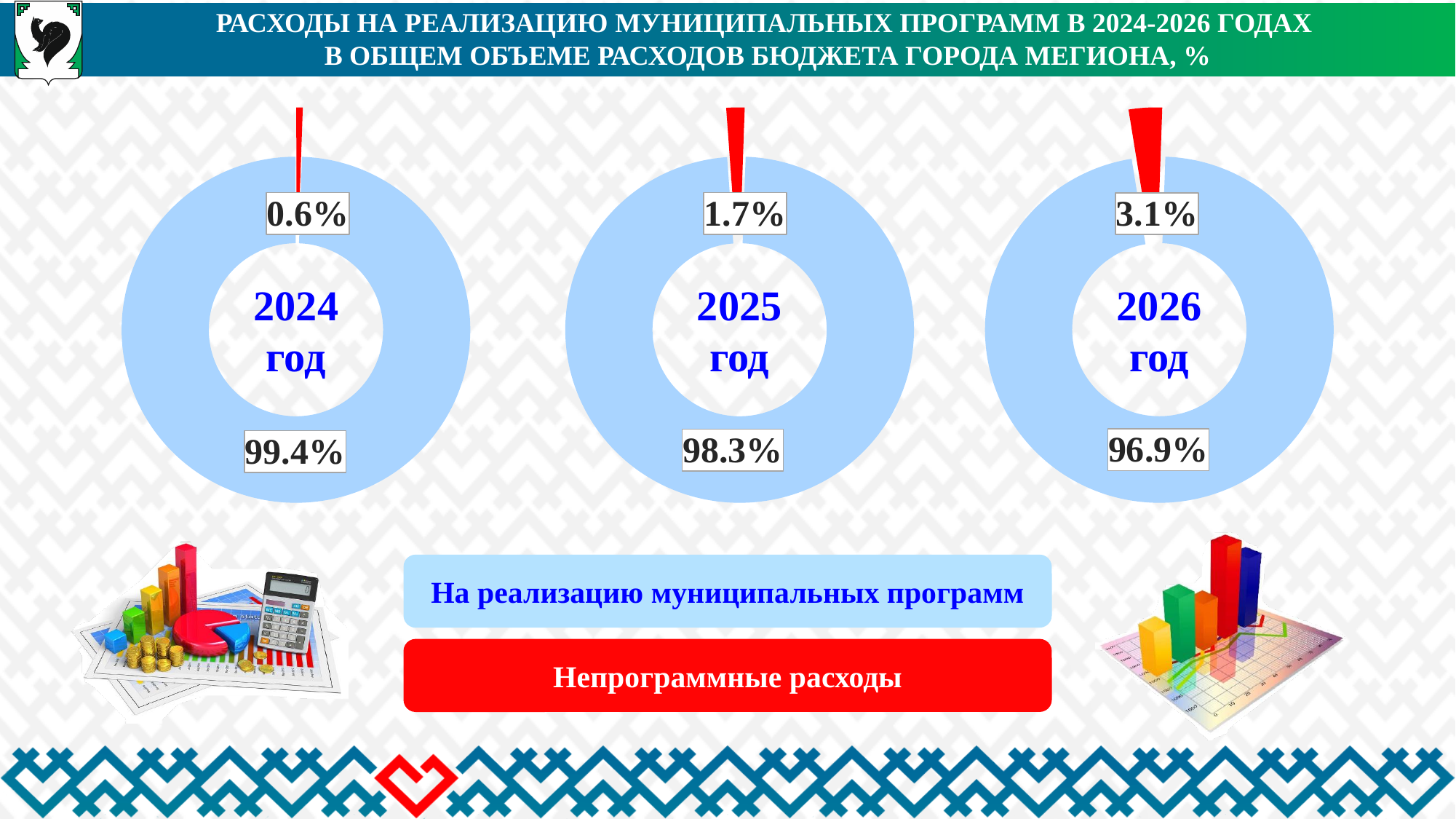
In the 2024 год donut chart, what share is shown for 'Непрограммные расходы'? 0.6% In the 2025 год donut chart, what share is shown for 'Непрограммные расходы'? 1.7% In the 2024 год donut chart, what share is shown for 'На реализацию муниципальных программ'? 99.4% What type of chart is used to show the 2025 год data? Donut (pie) chart Which colour represents 'Непрограммные расходы' in the donut charts? Red What is the difference between the 'Непрограммные расходы' share in the 2026 год chart and in the 2024 год chart? 2.5% Across the three donut charts, in which year is the share of 'Непрограммные расходы' the highest? 2026 год In the 2026 год donut chart, what share is shown for 'Непрограммные расходы'? 3.1% In the 2025 год donut chart, what share is shown for 'На реализацию муниципальных программ'? 98.3% Across the three donut charts, in which year is the share of 'На реализацию муниципальных программ' the lowest? 2026 год In the 2026 год donut chart, what share is shown for 'На реализацию муниципальных программ'? 96.9% How many donut charts are shown on the slide? 3